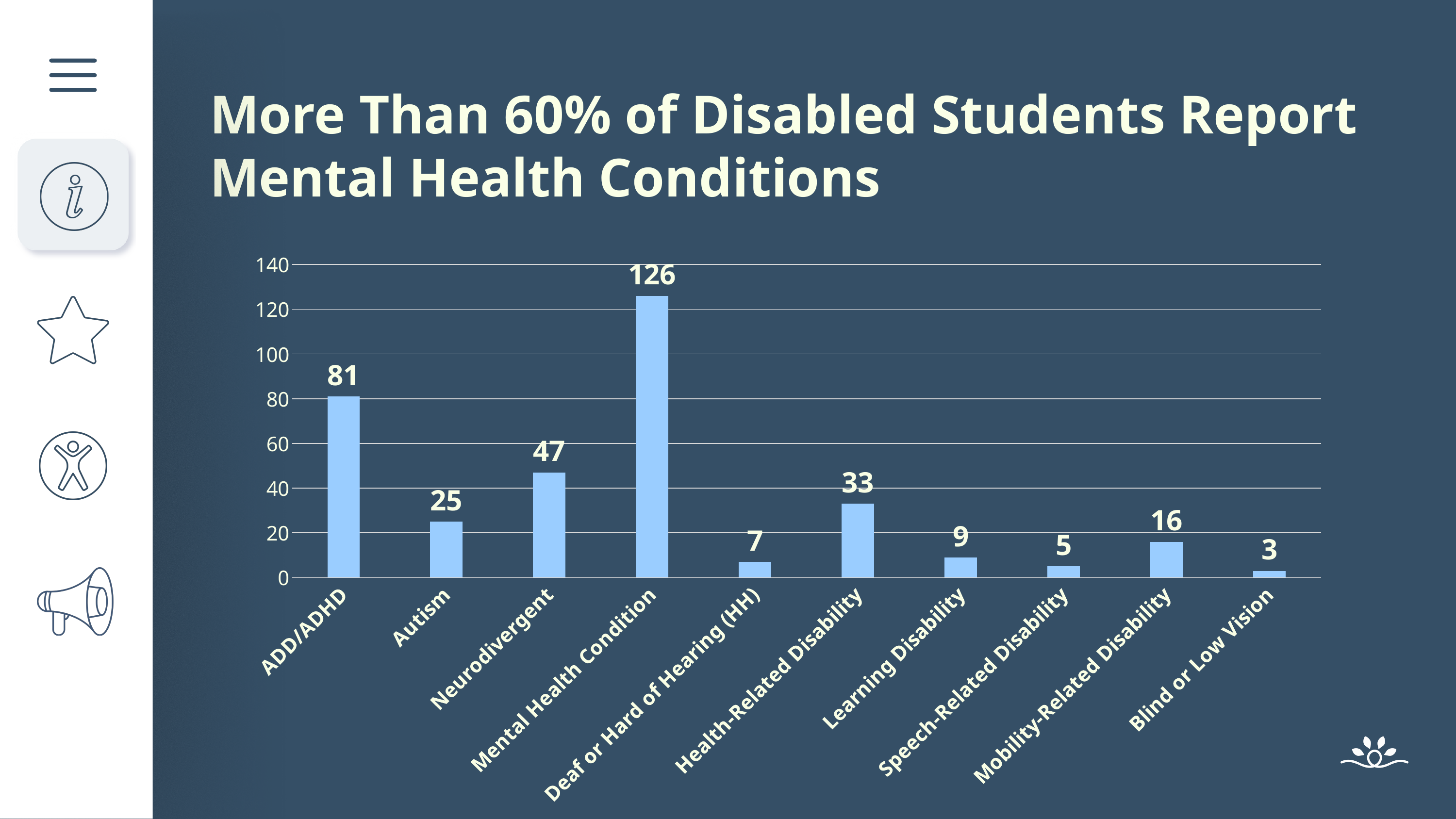
Is the value for Neurodivergent greater or less than 40? greater Which is larger, the value for Health-Related Disability or the value for Mobility-Related Disability? Health-Related Disability What is the value for ADD/ADHD? 81 How many categories are shown on the x axis? 10 Which category has the lowest value? Blind or Low Vision What is the value for Deaf or Hard of Hearing (HH)? 7 Which category has the highest value? Mental Health Condition What kind of chart is shown on the slide? bar chart What is the difference between the values for Mental Health Condition and ADD/ADHD? 45 What is the difference between the values for Neurodivergent and Autism? 22 What is the title of the slide? More Than 60% of Disabled Students Report Mental Health Conditions What is the value for Mental Health Condition? 126